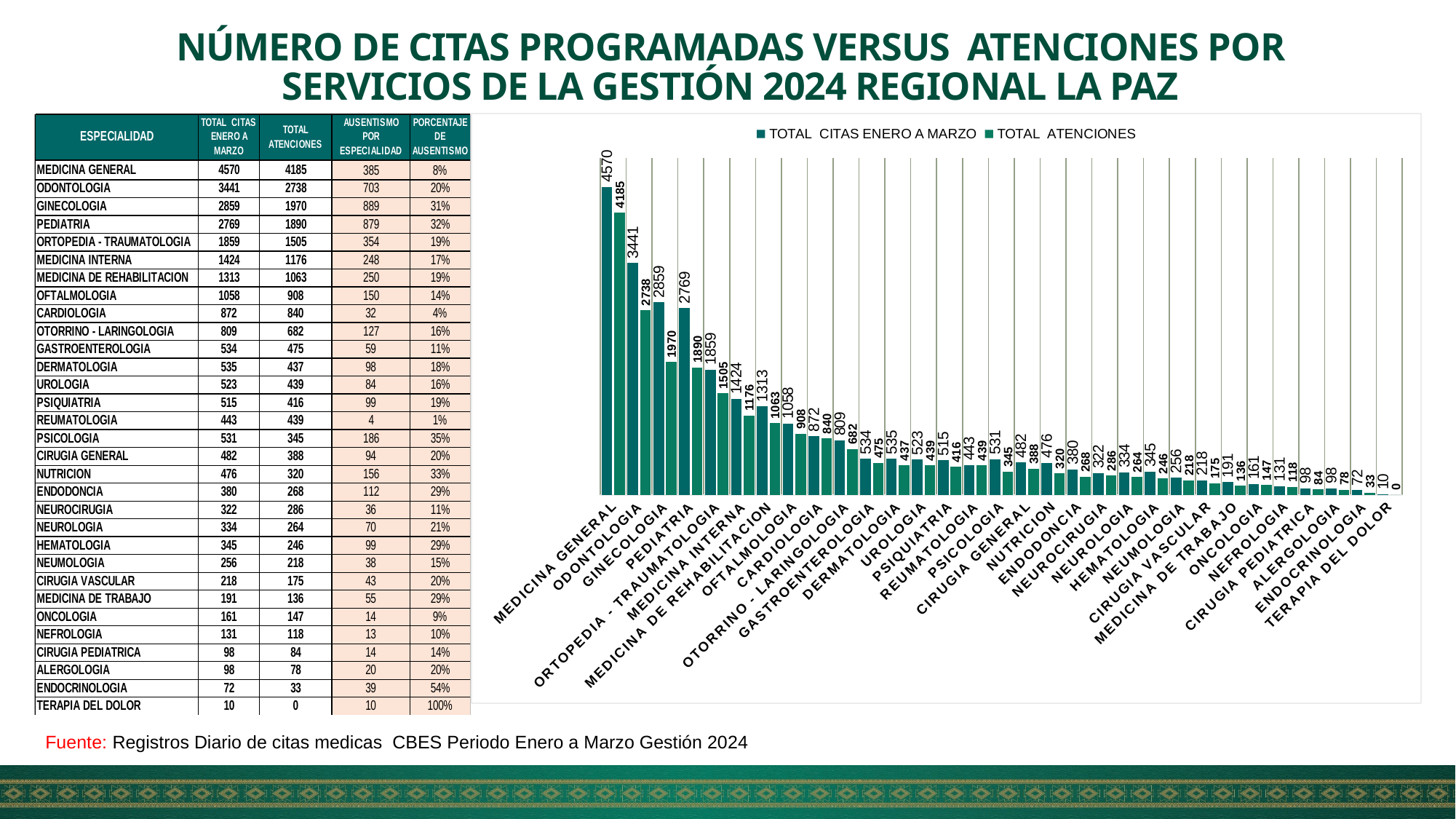
Which specialty has the highest TOTAL CITAS ENERO A MARZO in the chart? MEDICINA GENERAL What is the TOTAL ATENCIONES value for CARDIOLOGIA in the chart? 840 What is the TOTAL ATENCIONES value for ODONTOLOGIA in the chart? 2738 What is the TOTAL CITAS ENERO A MARZO value for ENDOCRINOLOGIA in the chart? 72 How many series does the chart legend list? 2 Do the TOTAL CITAS ENERO A MARZO values generally rise or fall from left to right along the x axis? fall How many specialties are shown on the x axis of the chart? 31 What is the TOTAL CITAS ENERO A MARZO value for MEDICINA GENERAL in the chart? 4570 What is the difference between TOTAL CITAS ENERO A MARZO and TOTAL ATENCIONES for PEDIATRIA in the chart? 879 Which specialty has the lowest TOTAL ATENCIONES in the chart? TERAPIA DEL DOLOR What kind of chart is shown on the slide? bar chart In the chart, which is larger for GINECOLOGIA: TOTAL CITAS ENERO A MARZO or TOTAL ATENCIONES? TOTAL CITAS ENERO A MARZO